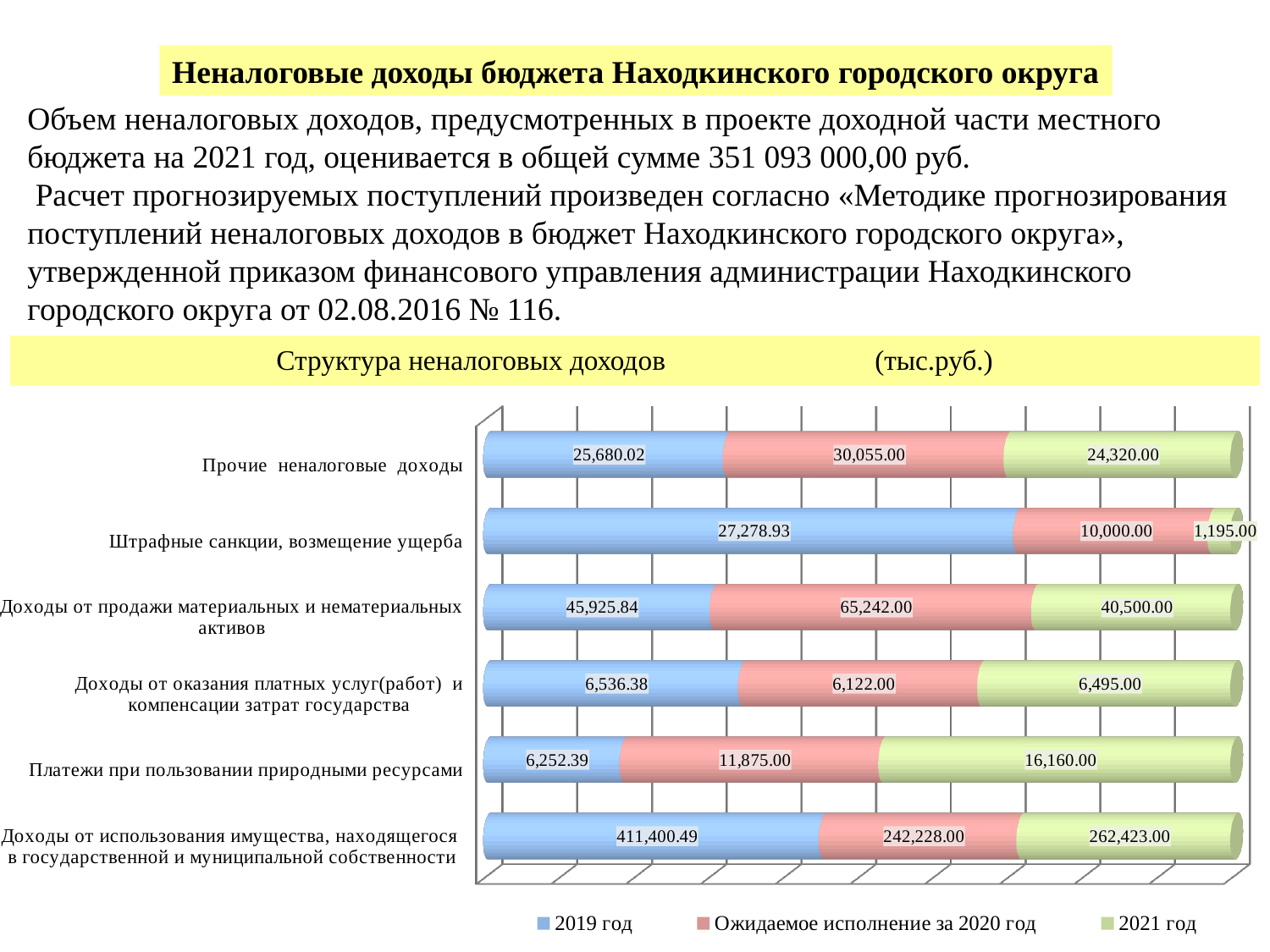
For «Прочие неналоговые доходы», what is the difference between the 2020 expected value and the 2021 value? 5,735.00 Which category has the highest 2021 год value? Доходы от использования имущества, находящегося в государственной и муниципальной собственности How many income categories are shown on the chart? 6 What type of chart is shown under the heading «Структура неналоговых доходов»? Stacked bar chart What is the «Ожидаемое исполнение за 2020 год» value for «Доходы от продажи материальных и нематериальных активов»? 65,242.00 For «Платежи при пользовании природными ресурсами», which is larger: the 2019 год value or the 2021 год value? 2021 год What is the total of the three values in the bar for «Платежи при пользовании природными ресурсами»? 34,287.39 What is the 2021 год value for «Штрафные санкции, возмещение ущерба»? 1,195.00 What unit is indicated in the chart heading? тыс.руб. How many series does the legend of the chart list? 3 What is the 2019 год value for «Доходы от использования имущества, находящегося в государственной и муниципальной собственности»? 411,400.49 Which category has the lowest 2021 год value? Штрафные санкции, возмещение ущерба